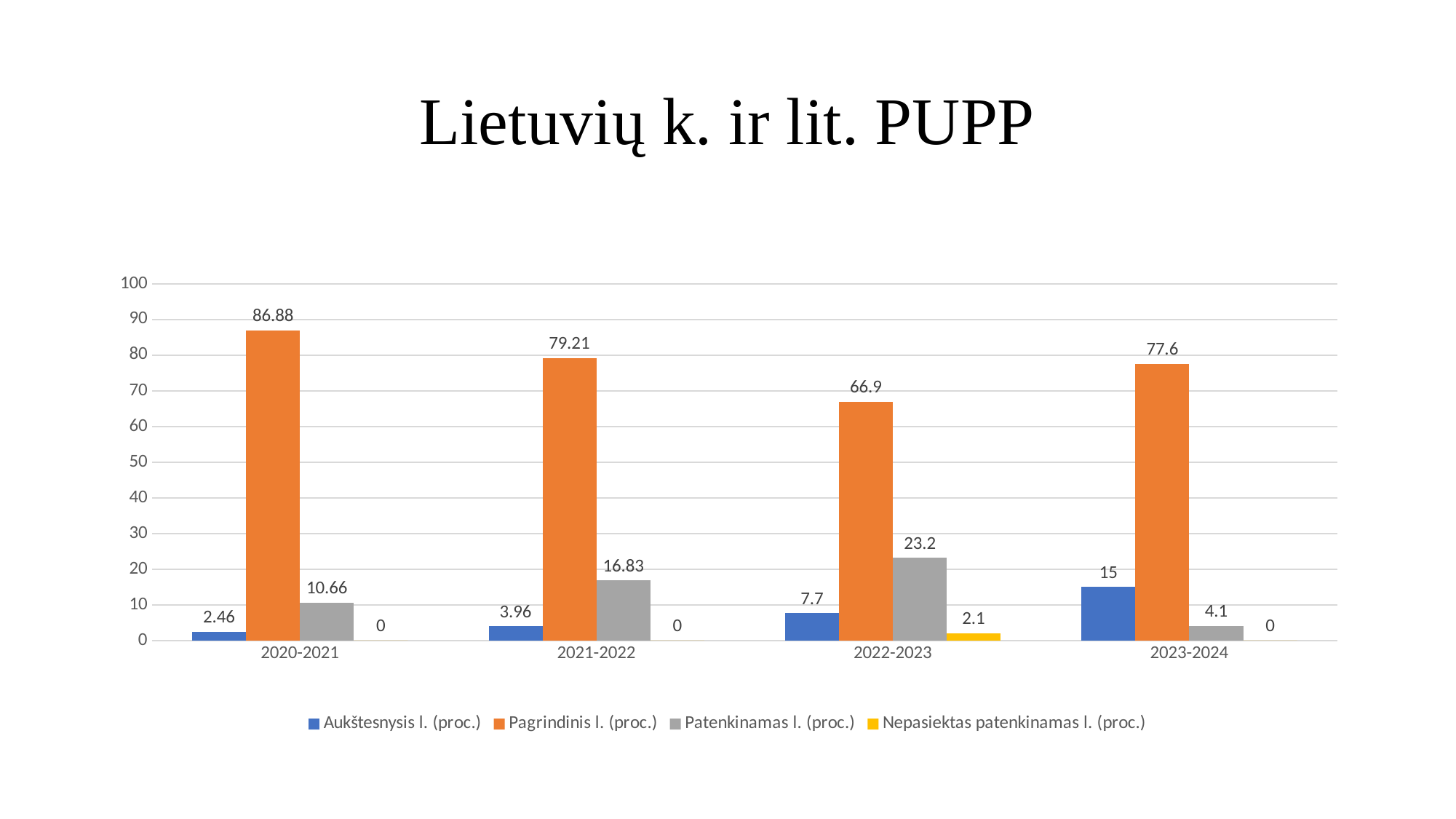
In which school year is the Pagrindinis l. (proc.) value highest? 2020-2021 In which school year is the Aukštesnysis l. (proc.) value lowest? 2020-2021 What is the difference between the Pagrindinis l. (proc.) values for 2020-2021 and 2021-2022? 7.67 Does the Aukštesnysis l. (proc.) value rise or fall from 2020-2021 to 2023-2024? Rise How many school years are shown on the x axis? 4 Which is larger: Patenkinamas l. (proc.) in 2021-2022 or in 2023-2024? 2021-2022 What kind of chart is shown on the slide? Bar chart What is the value for Aukštesnysis l. (proc.) in 2023-2024? 15 What is the value for Pagrindinis l. (proc.) in 2020-2021? 86.88 How many series does the legend list? 4 What is the value for Nepasiektas patenkinamas l. (proc.) in 2022-2023? 2.1 What is the value for Patenkinamas l. (proc.) in 2022-2023? 23.2